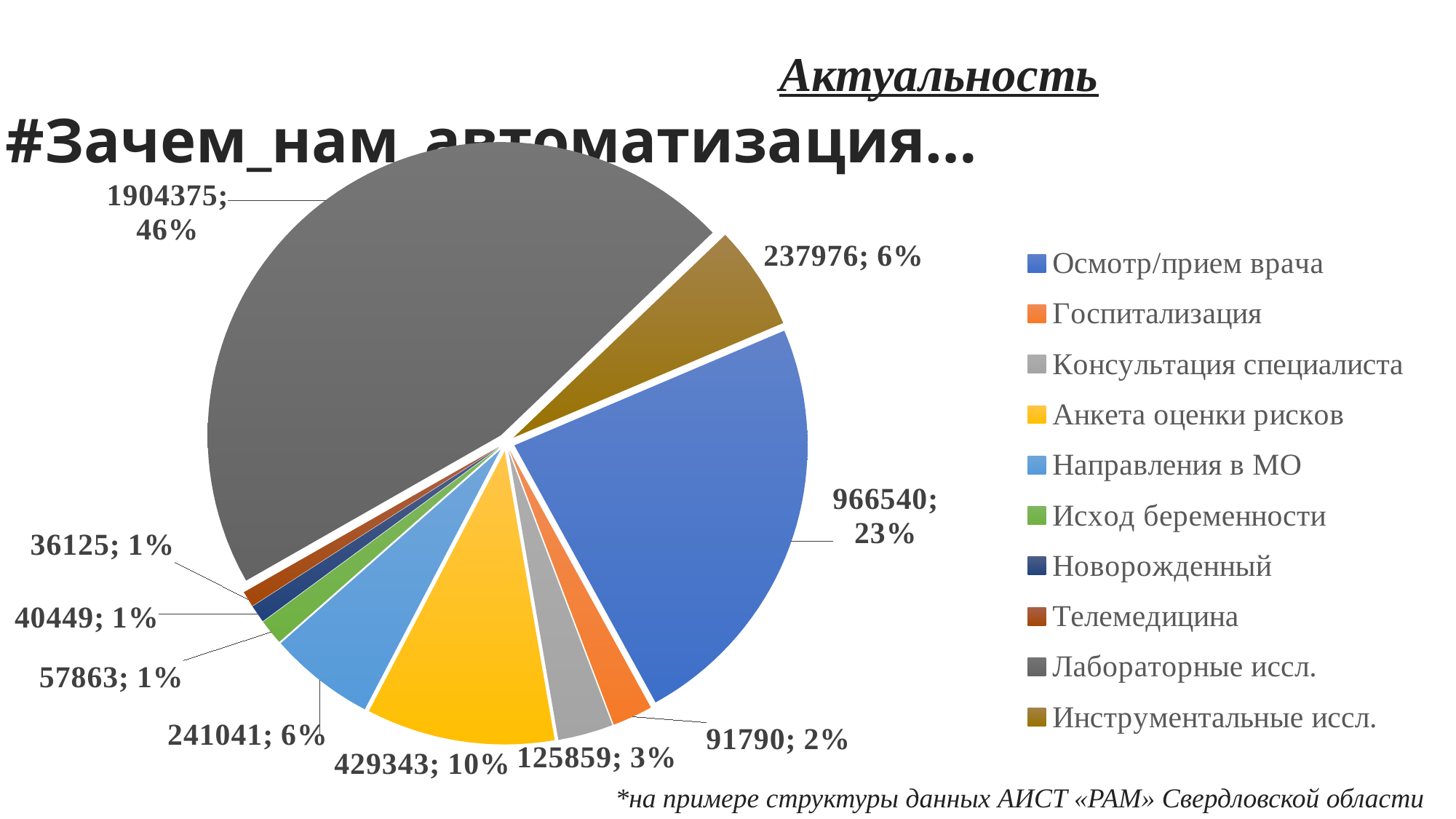
What value is shown for Госпитализация? 91790 What percentage share does Осмотр/прием врача have in the pie? 23% What is the difference between the values for Осмотр/прием врача and Анкета оценки рисков? 537197 What colour is the slice for Анкета оценки рисков? yellow What percentage share does Консультация специалиста have? 3% What value is shown for Анкета оценки рисков? 429343 Which is larger: the value for Направления в МО or for Инструментальные иссл.? Направления в МО How many categories does the pie chart have? 10 Which category has the smallest value in the pie? Телемедицина Which category has the largest slice of the pie? Лабораторные иссл. What value is shown for Лабораторные иссл.? 1904375 What kind of chart is shown on the slide? pie chart